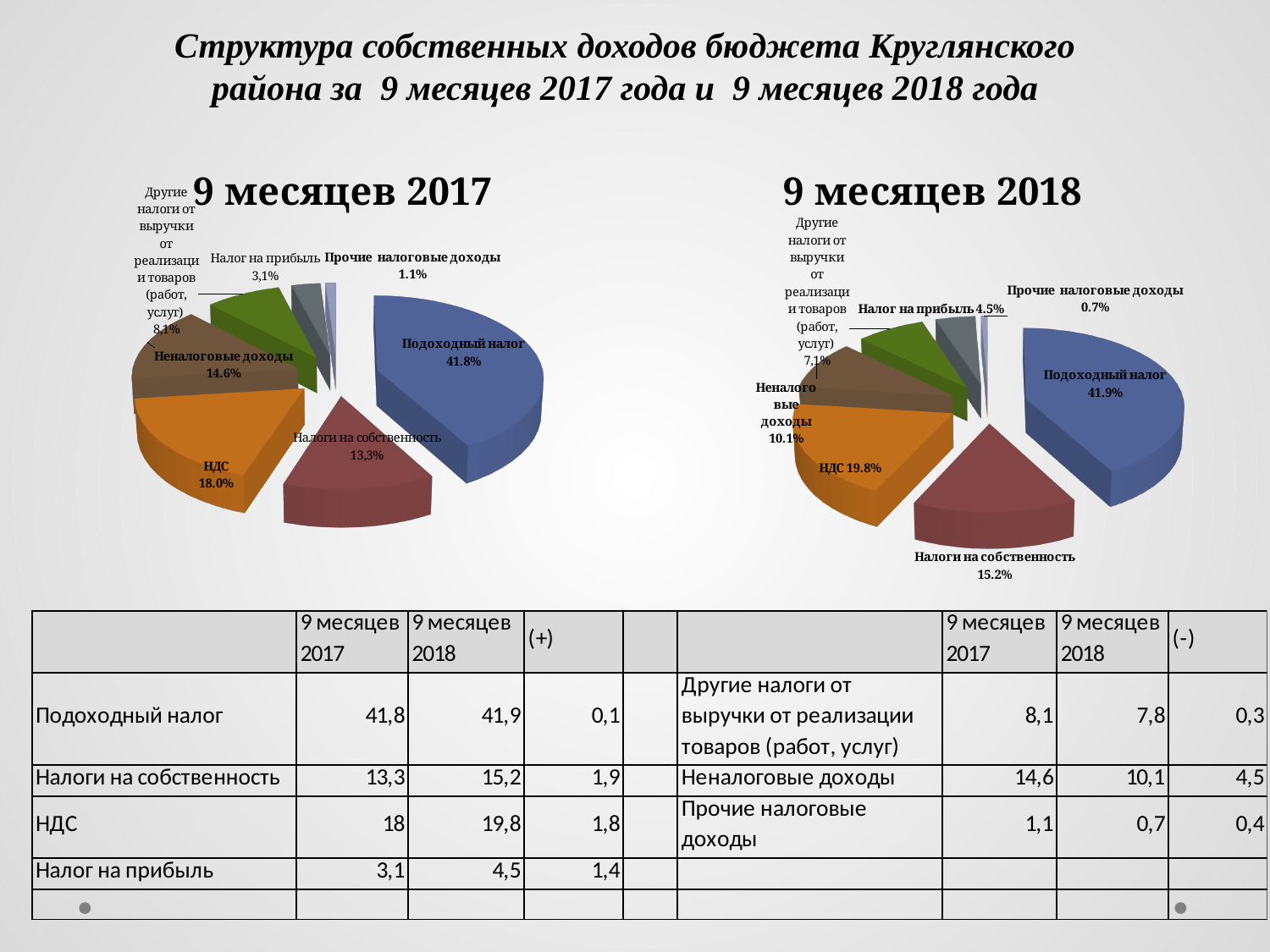
In the "9 месяцев 2017" chart, which is larger: НДС or Налоги на собственность? НДС What type of chart is used for "9 месяцев 2018"? Pie chart In the "9 месяцев 2018" chart, what share does НДС have? 19.8% How many slices does the "9 месяцев 2017" chart have? 7 In the "9 месяцев 2018" chart, what share does Налог на прибыль have? 4.5% In the "9 месяцев 2017" chart, which category has the largest slice? Подоходный налог In the "9 месяцев 2018" chart, which category has the smallest slice? Прочие налоговые доходы In the "9 месяцев 2018" chart, what share does Налоги на собственность have? 15.2% In the "9 месяцев 2017" chart, what share does Неналоговые доходы have? 14.6% In the "9 месяцев 2018" chart, what is the difference between the shares of Подоходный налог and НДС? 22.1% In the "9 месяцев 2017" chart, what colour is the Подоходный налог slice? Blue In the "9 месяцев 2017" chart, what share does Подоходный налог have? 41.8%